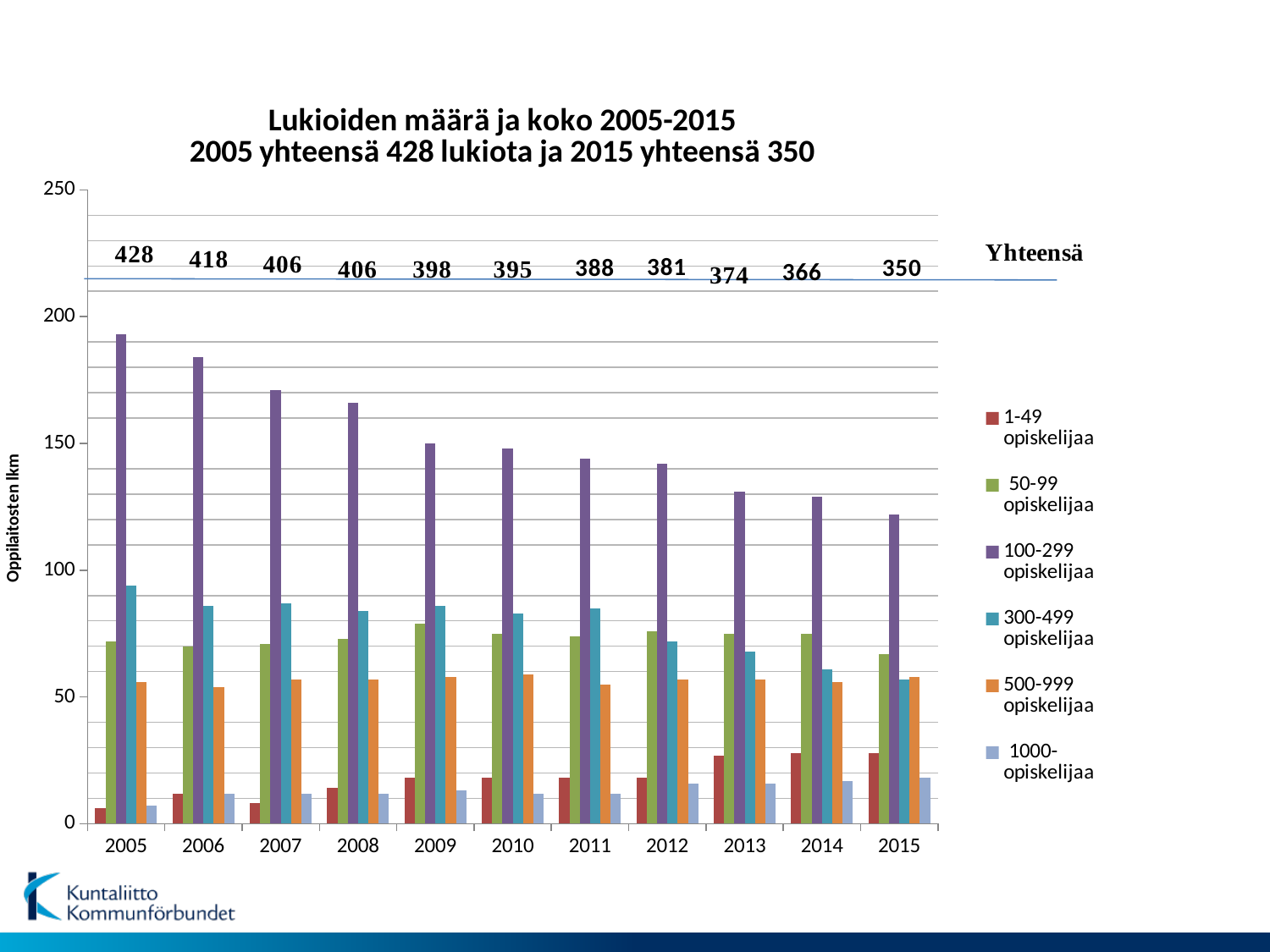
By how much did the total number of lukiot (Yhteensä) fall from 2005 to 2015? 78 What is the total number of lukiot (Yhteensä) shown for 2005? 428 Is the value for 100-299 opiskelijaa in 2015 greater or less than 150? less What is the total (Yhteensä) label shown for 2009? 398 How many years are shown on the x axis? 11 What kind of chart is shown on the slide? bar chart Do the Yhteensä totals rise or fall from 2005 to 2015? fall What is the difference between the Yhteensä totals for 2006 and 2007? 12 What is the total (Yhteensä) label shown for 2012? 381 How many series does the legend list? 6 What is the total number of lukiot (Yhteensä) shown for 2015? 350 Which series has the tallest bar in 2005? 100-299 opiskelijaa